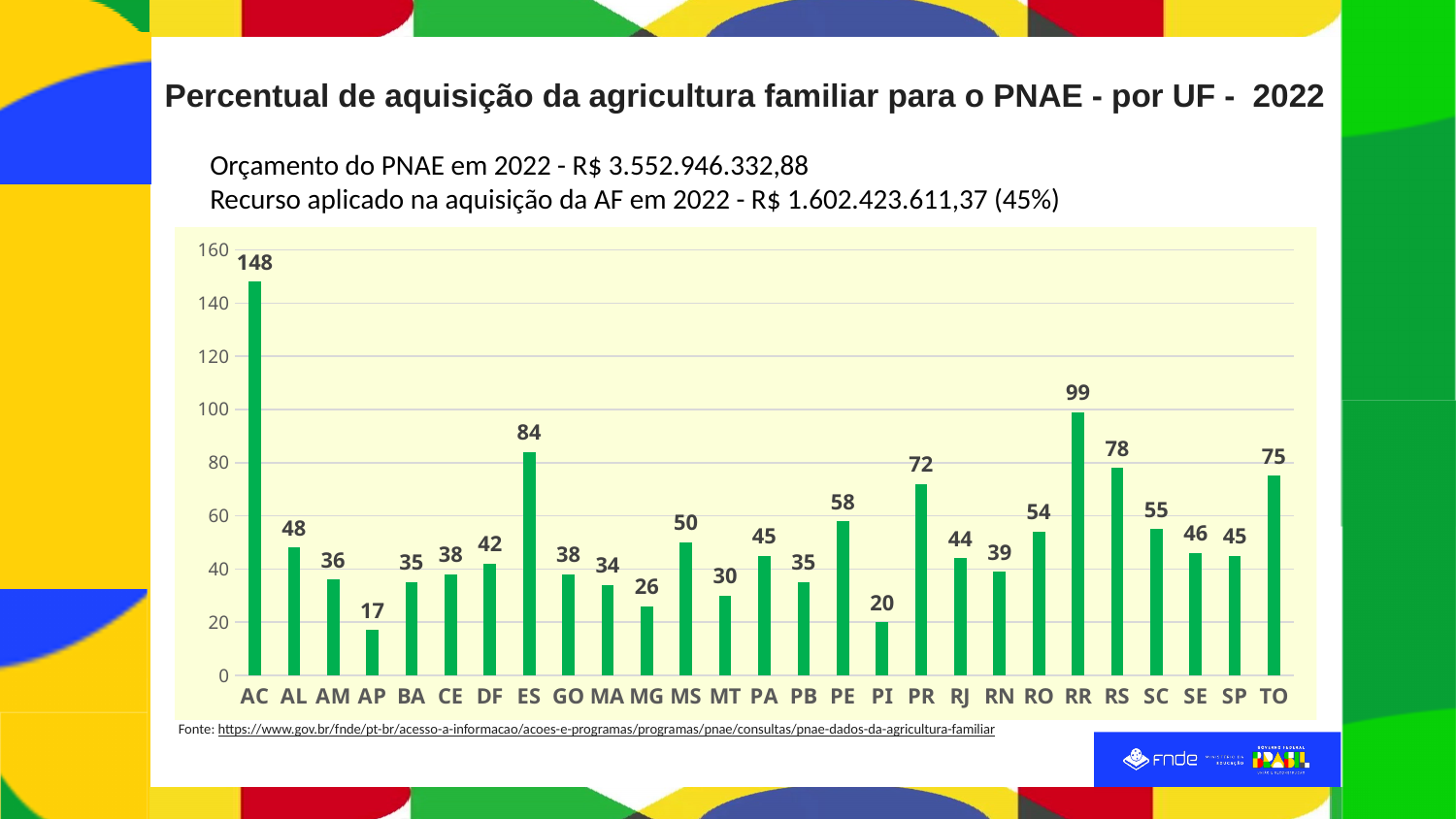
What is the difference between the values for PR and PI? 52 Which UF has the lowest value? AP What is the title of the slide's chart? Percentual de aquisição da agricultura familiar para o PNAE - por UF - 2022 What is the value for ES? 84 What is the value for RR? 99 How many UFs are shown on the x axis? 27 Which is larger, the value for RS or the value for TO? RS What is the difference between the values for AC and RR? 49 Which UF has the highest value? AC Is the value for PE greater or less than 60? less What is the value for MG? 26 What kind of chart is shown on the slide? bar chart